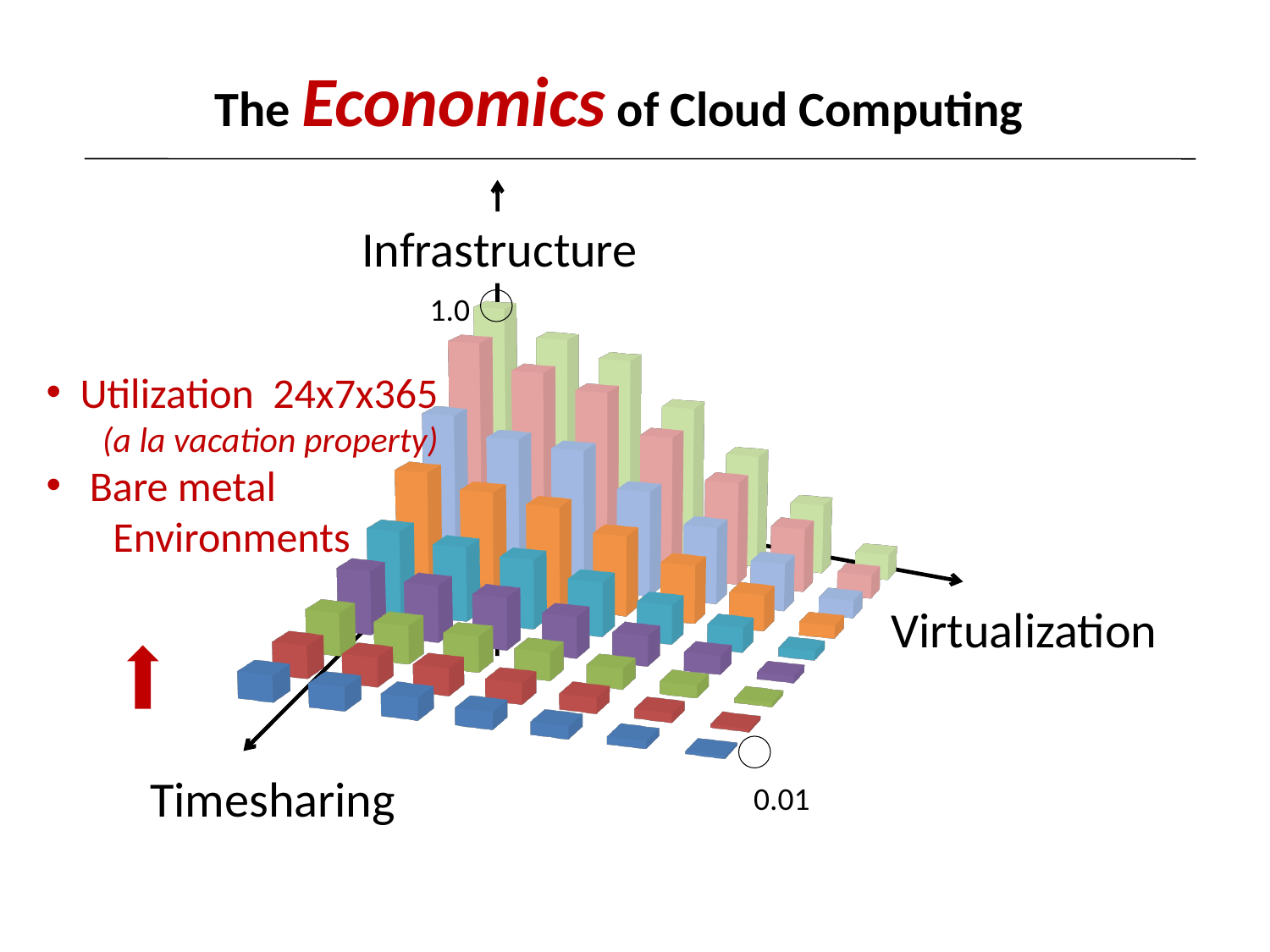
What value is marked at the top of the tallest bar, next to the Infrastructure axis? 1.0 Which is larger, the value marked 1.0 or the value marked 0.01? 1.0 What are the three axis labels on the chart? Infrastructure, Virtualization, Timesharing What kind of chart is shown on the slide? bar chart What value is marked at the front-right corner of the chart, next to the smallest bar? 0.01 Moving from the front (Timesharing end) toward the back of the chart, do the bar heights rise or fall? rise How many distinct bar colours are used in the chart? 9 Moving along the Virtualization axis toward the right, do the bar heights rise or fall? fall What is the title of the slide containing the chart? The Economics of Cloud Computing